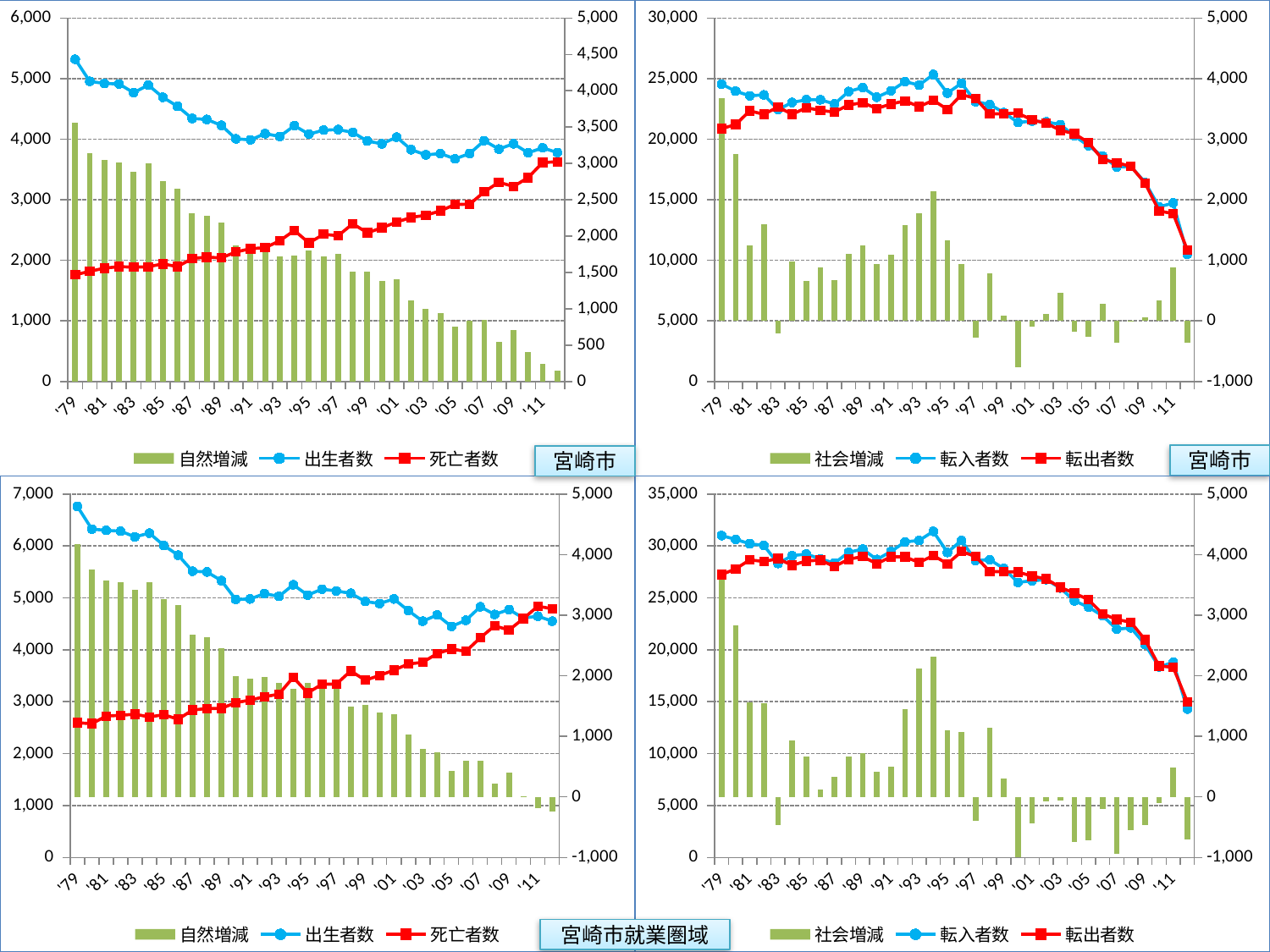
On the top-left chart (宮崎市, 自然増減), does 死亡者数 rise or fall from '79 to '11? Rise On the top-right chart (宮崎市, 社会増減), is the value of 転入者数 in '79 greater or less than 20,000 on the left axis? greater On the top-left chart (宮崎市, 自然増減), does 出生者数 rise or fall from '79 to '11? Fall On the bottom-right chart (宮崎市就業圏域, 社会増減), is the value of 転出者数 in '79 greater or less than 30,000 on the left axis? less On the bottom-left chart (宮崎市就業圏域, 自然増減), is the value of 出生者数 in '79 greater or less than 6,000 on the left axis? greater On the top-right chart (宮崎市, 社会増減), what are the three legend entries? 社会増減, 転入者数, 転出者数 On the top-left chart (宮崎市, 自然増減), what kind of chart is it? Combination bar and line chart On the top-left chart (宮崎市, 自然増減), in '79, which is larger: 出生者数 or 死亡者数? 出生者数 On the bottom-left chart (宮崎市就業圏域, 自然増減), in which year is 出生者数 highest? '79 On the top-left chart (宮崎市, 自然増減), how many series does the legend list? 3 On the bottom-right chart (宮崎市就業圏域, 社会増減), does 転入者数 rise or fall from '97 to '11? Fall